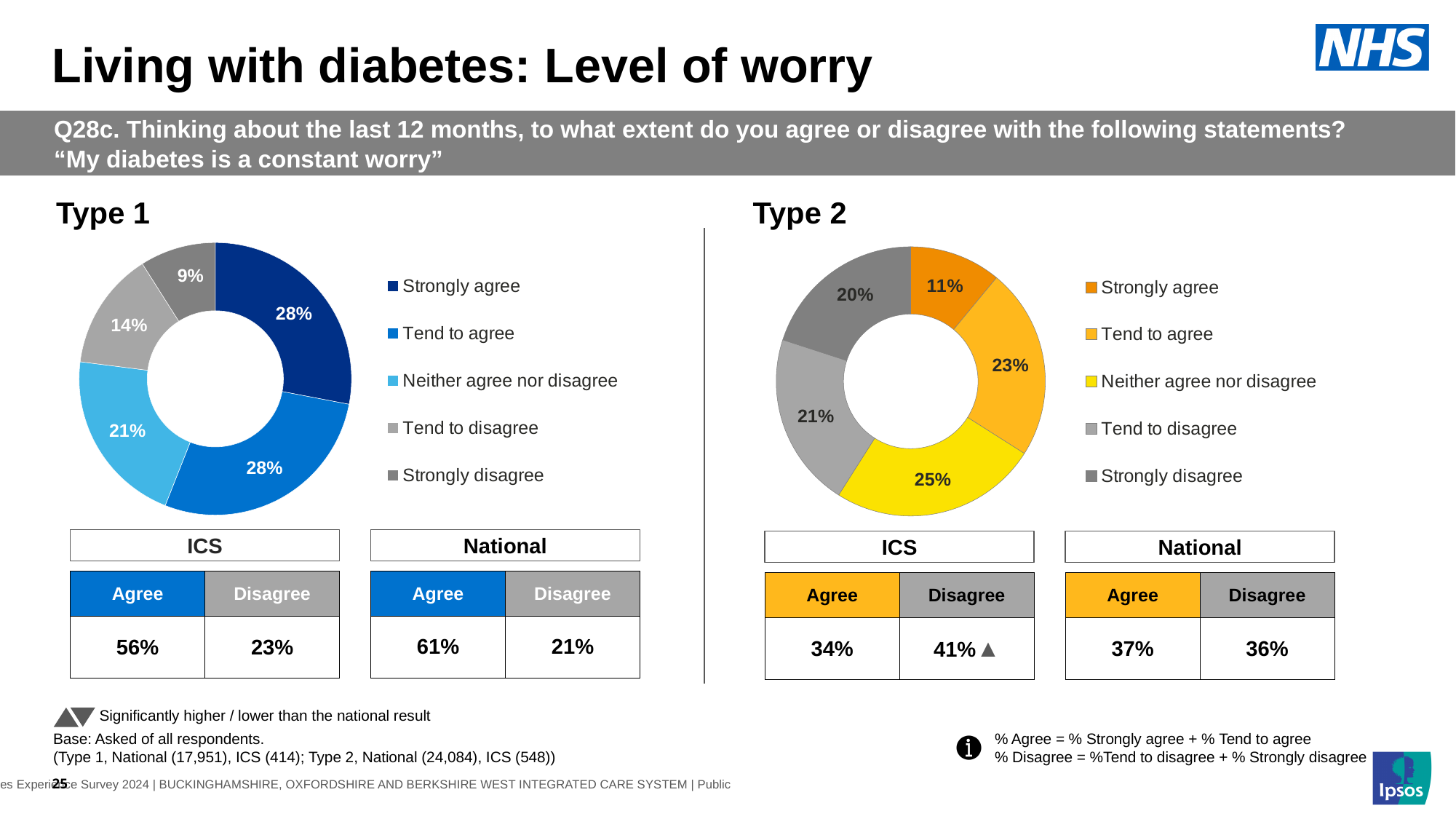
In the Type 2 chart, which response category has the smallest share? Strongly agree In the Type 2 chart, which response category has the largest share? Neither agree nor disagree In the Type 1 chart, what is the difference between the 'Tend to agree' share and the 'Tend to disagree' share? 14 percentage points In the Type 1 chart, what percentage of respondents said 'Neither agree nor disagree'? 21% In the Type 2 chart, what percentage of respondents said 'Tend to disagree'? 21% How many response categories does the legend of the Type 1 chart list? 5 In the Type 2 chart, what percentage of respondents said 'Strongly agree'? 11% Which is larger in the Type 2 chart: the 'Tend to agree' share or the 'Strongly disagree' share? Tend to agree In the Type 2 chart, what is the difference between the 'Neither agree nor disagree' share and the 'Strongly disagree' share? 5 percentage points What type of chart is used to show the Type 1 results? Doughnut (pie) chart In the Type 1 chart, what percentage of respondents said 'Strongly disagree'? 9% In the Type 1 chart, which response category has the smallest share? Strongly disagree